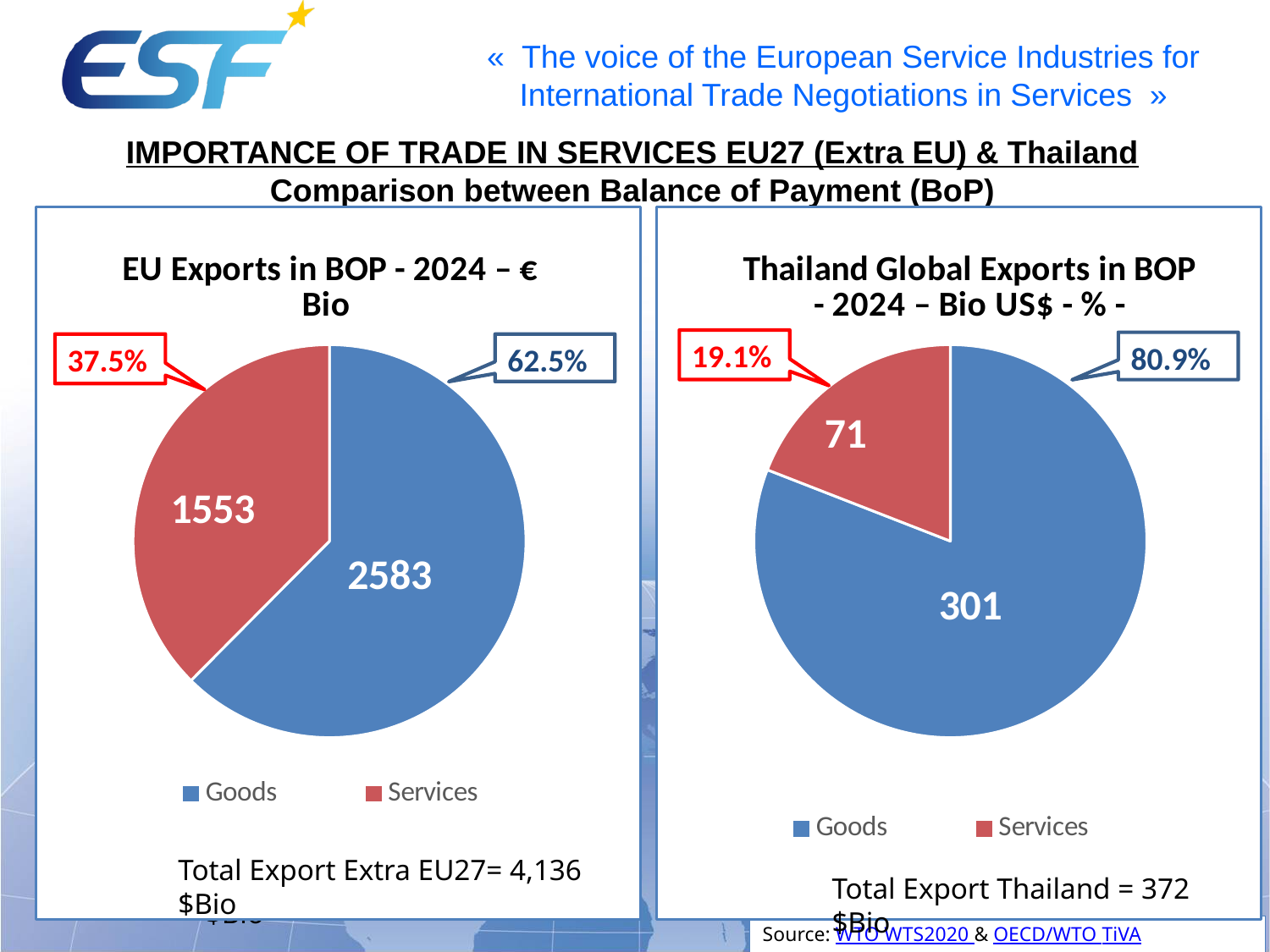
In the 'EU Exports in BOP - 2024' chart, which category is the largest? Goods What type of chart is the 'Thailand Global Exports in BOP - 2024' chart? Pie chart How many categories does the legend of the 'EU Exports in BOP - 2024' chart list? 2 In the 'Thailand Global Exports in BOP - 2024' chart, what is the value for Goods? 301 In the 'EU Exports in BOP - 2024' chart, what is the value for Goods? 2583 In the 'EU Exports in BOP - 2024' chart, what is the value for Services? 1553 In the 'Thailand Global Exports in BOP - 2024' chart, what is the value for Services? 71 In the 'Thailand Global Exports in BOP - 2024' chart, what is the difference between the Goods and Services values? 230 In the 'Thailand Global Exports in BOP - 2024' chart, which category is the smallest? Services In the 'Thailand Global Exports in BOP - 2024' chart, what share of the pie does Goods represent? 80.9% In the 'EU Exports in BOP - 2024' chart, what is the difference between the Goods and Services values? 1030 In the 'EU Exports in BOP - 2024' chart, what share of the pie does Services represent? 37.5%